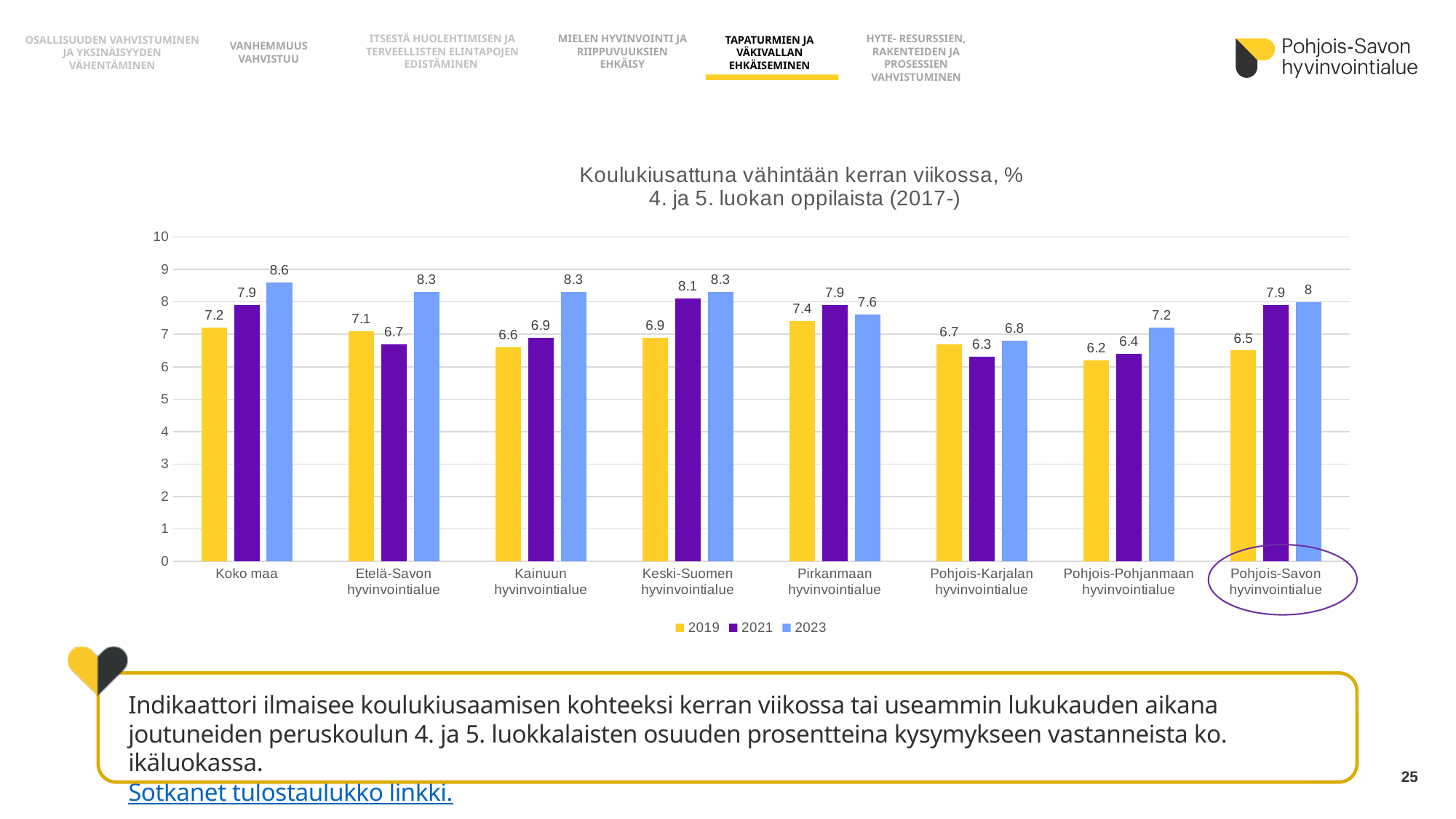
Do the values for Kainuun hyvinvointialue rise or fall from 2019 to 2023? rise Which is larger for Pirkanmaan hyvinvointialue: the 2021 value or the 2023 value? 2021 What is the 2019 value for Pohjois-Pohjanmaan hyvinvointialue? 6.2 How many categories are shown on the x axis? 8 Which colour represents the 2021 series in the legend? purple How many series does the legend list? 3 What is the 2023 value for Koko maa? 8.6 What is the difference between the 2023 and 2019 values for Pohjois-Savon hyvinvointialue? 1.5 What kind of chart is shown on the slide? bar chart Which category has the highest 2023 value? Koko maa What is the 2021 value for Pohjois-Savon hyvinvointialue? 7.9 Which category has the lowest 2019 value? Pohjois-Pohjanmaan hyvinvointialue